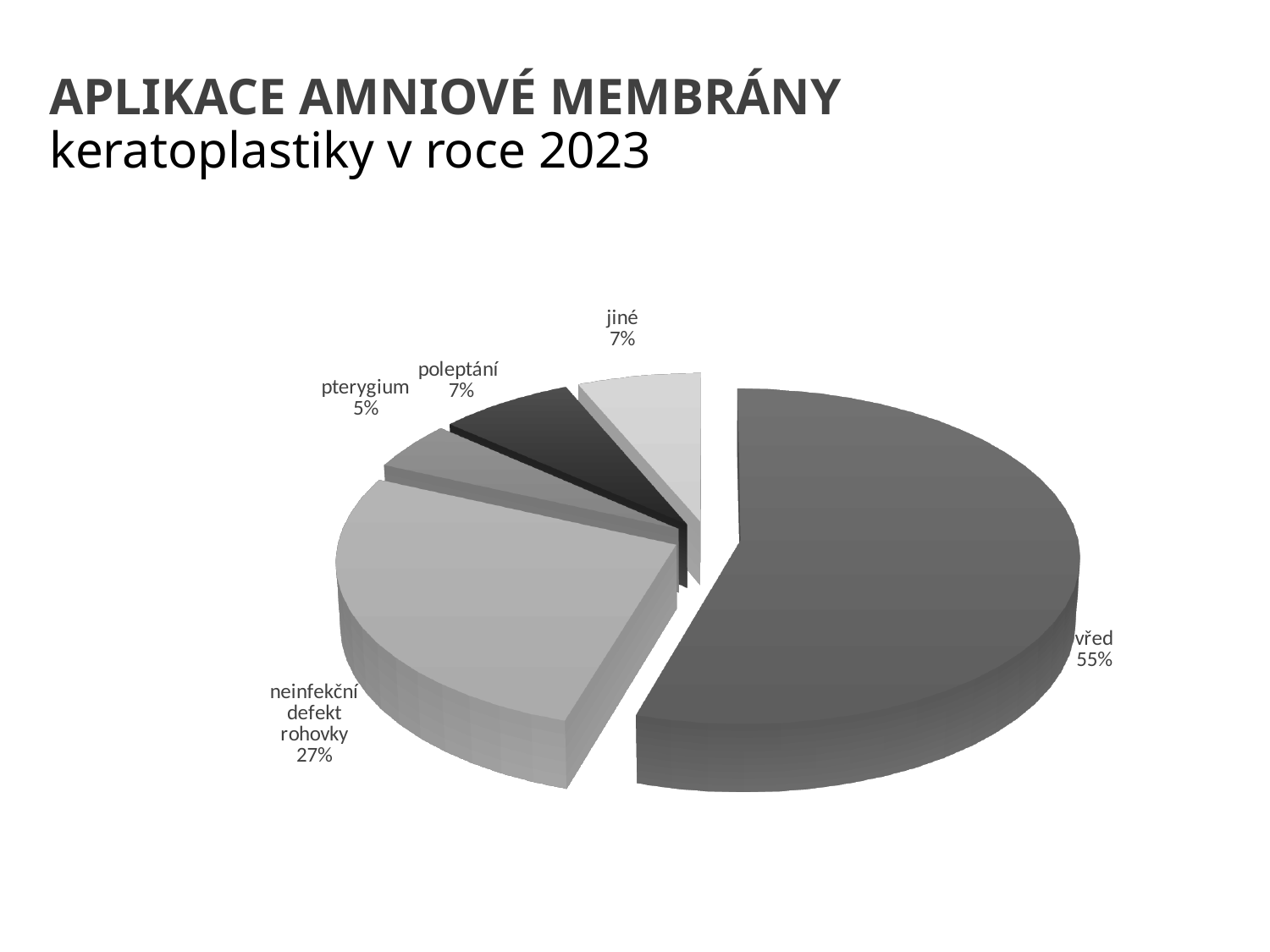
What kind of chart is shown on the slide? pie chart What is the value shown for 'poleptání'? 7% What is the title of the slide containing the chart? APLIKACE AMNIOVÉ MEMBRÁNY keratoplastiky v roce 2023 What is the value shown for 'jiné'? 7% Which is larger, the slice for 'neinfekční defekt rohovky' or the slice for 'poleptání'? neinfekční defekt rohovky What share of the pie does 'neinfekční defekt rohovky' represent? 27% What share of the pie does the 'vřed' slice represent? 55% Which category has the largest slice of the pie? vřed What is the difference in percentage points between 'vřed' and 'neinfekční defekt rohovky'? 28 What is the value shown for 'pterygium'? 5% How many slices does the pie chart have? 5 Which category has the smallest slice of the pie? pterygium